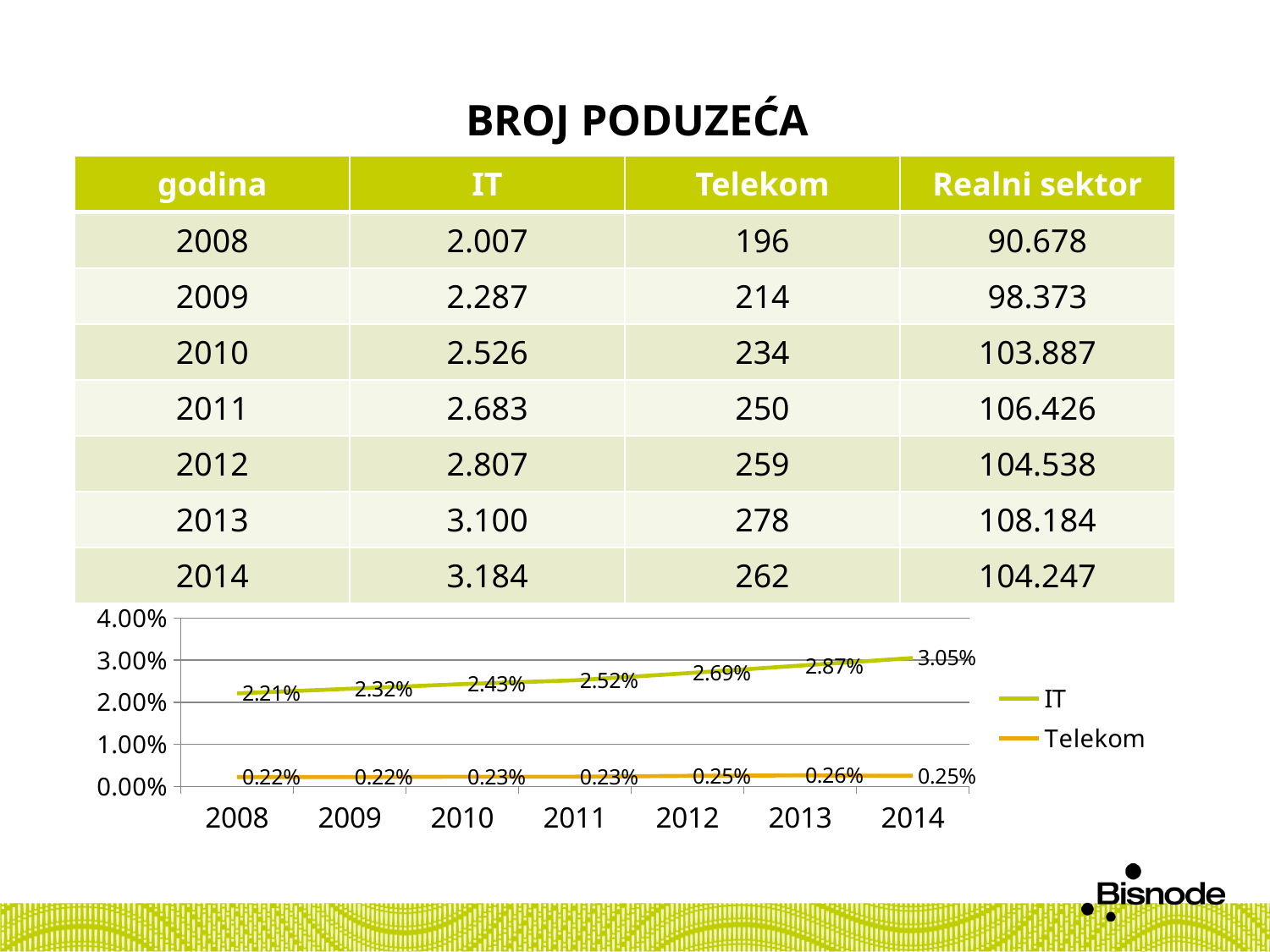
How many years are plotted on the x axis of the chart? 7 Which series has the larger value in 2012, IT or Telekom? IT Does the IT series rise or fall from 2008 to 2014? rise In which year is the IT series at its lowest? 2008 What is the difference between the IT value in 2014 and the IT value in 2008? 0.84% What is the value of the IT series in 2008? 2.21% What type of chart is shown below the table on the slide? line chart What is the value of the IT series in 2014? 3.05% How many series does the chart legend list? 2 What is the value of the Telekom series in 2013? 0.26% Is the IT value for 2013 greater or less than 3.00%? less In which year is the IT series at its highest? 2014